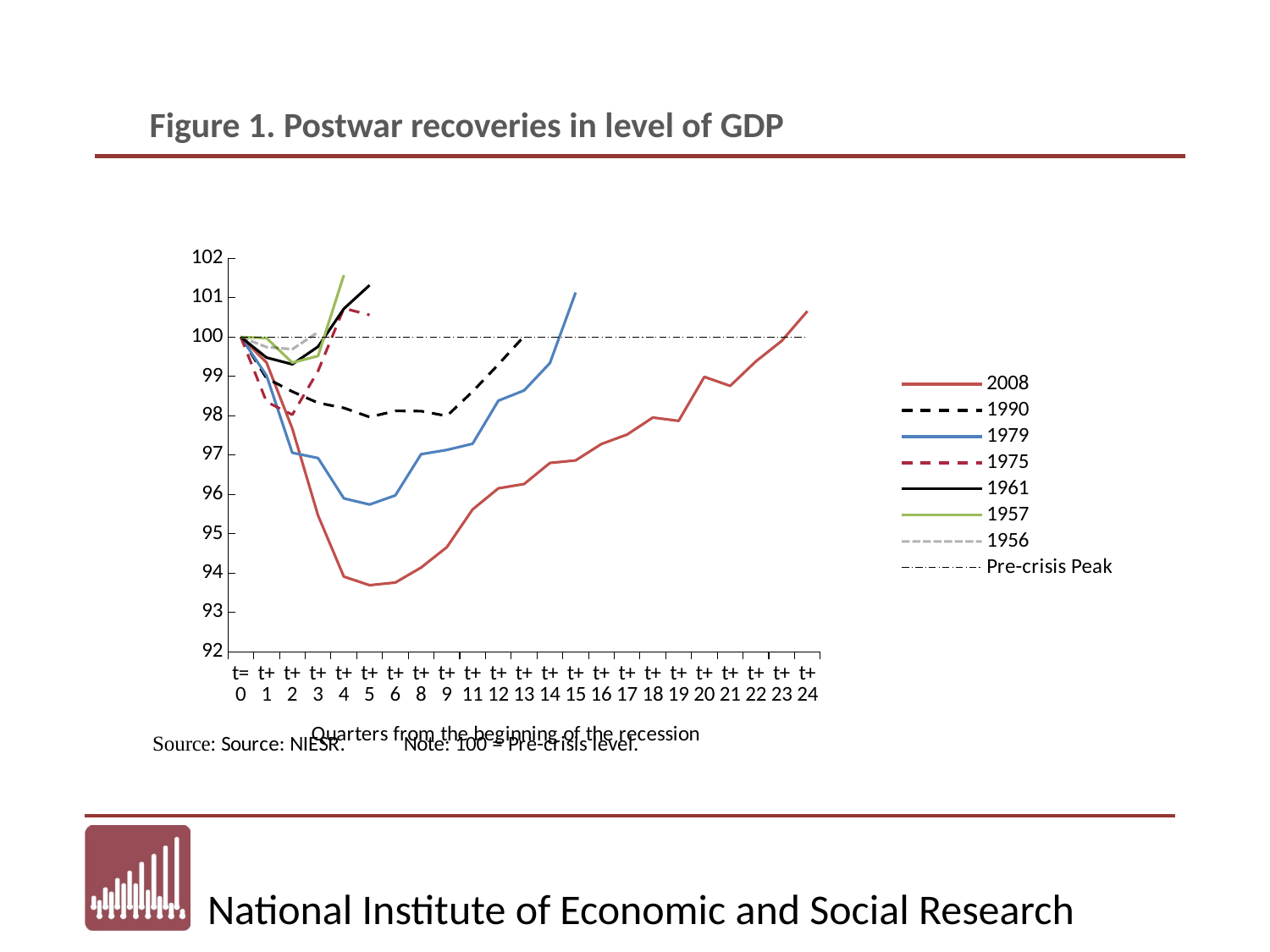
Is the value for 1979 at t+15 greater or less than 100? greater Is the value for 2008 at t+24 greater or less than 100? greater Does the 2008 series rise or fall from t+5 to t+24? rise Is the value for 2008 at t+5 greater or less than 94? less What kind of chart is shown on the slide? line chart How many series does the legend list? 8 Which series is drawn as the solid blue line? 1979 At t+5, which series is higher, 1979 or 2008? 1979 At what level is the Pre-crisis Peak line drawn? 100 Which series falls to the lowest level of GDP? 2008 What is the title of the chart? Figure 1. Postwar recoveries in level of GDP